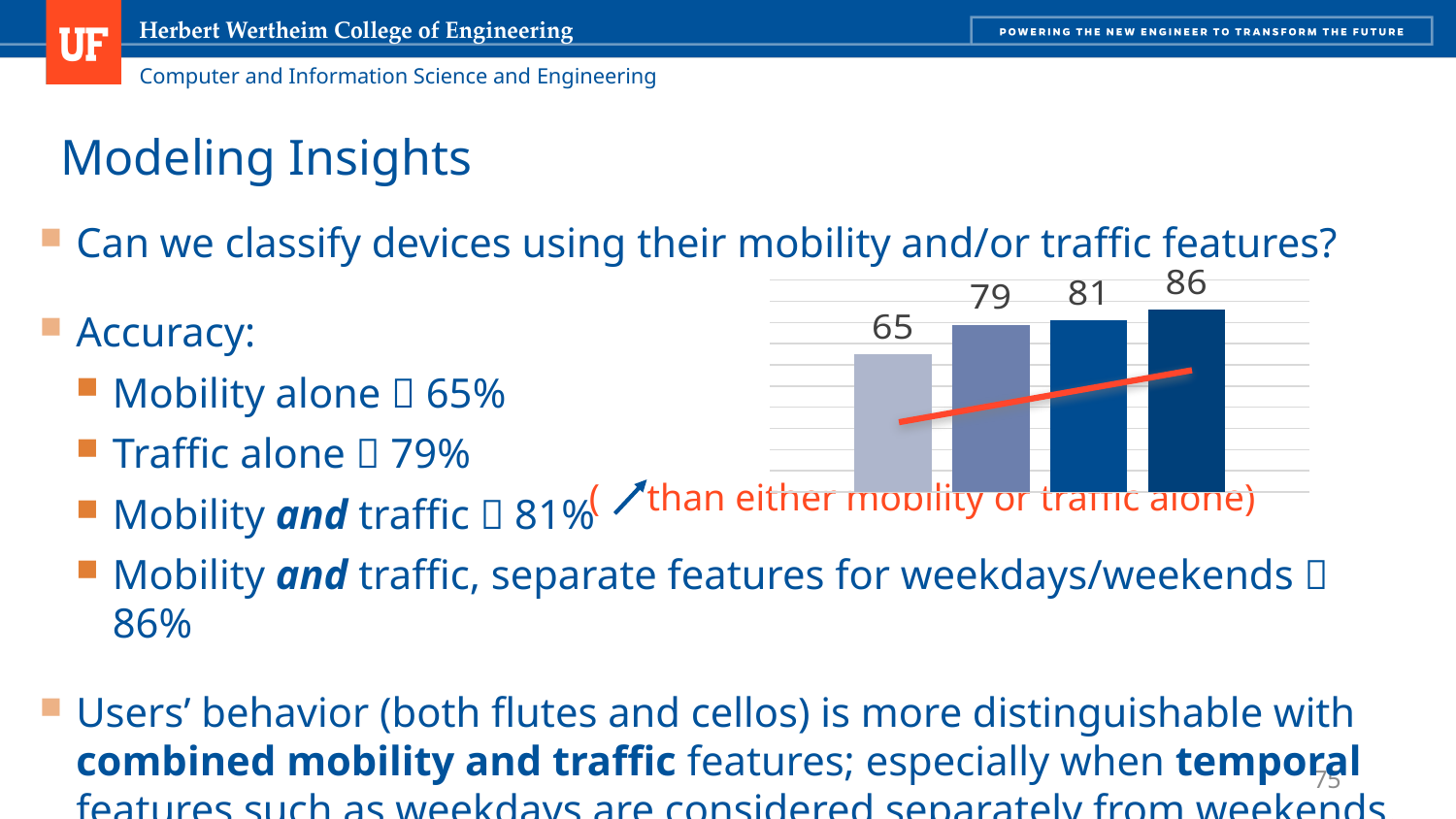
Which bar in the chart has the highest value? the fourth (rightmost) bar, 86 Do the bar values rise or fall from left to right across the chart? rise What is the difference between the rightmost bar (86) and the leftmost bar (65) in the chart? 21 What type of chart is shown on the slide? bar chart Which bar in the chart has the lowest value? the first (leftmost) bar, 65 What is the data label on the fourth (rightmost) bar of the chart? 86 Which is larger in the chart, the third bar or the second bar? the third bar (81) What is the difference between the second bar (79) and the first bar (65) in the chart? 14 What is the data label on the second bar of the chart? 79 What is the data label on the first (leftmost) bar of the chart? 65 How many bars are plotted in the chart? 4 What is the data label on the third bar of the chart? 81